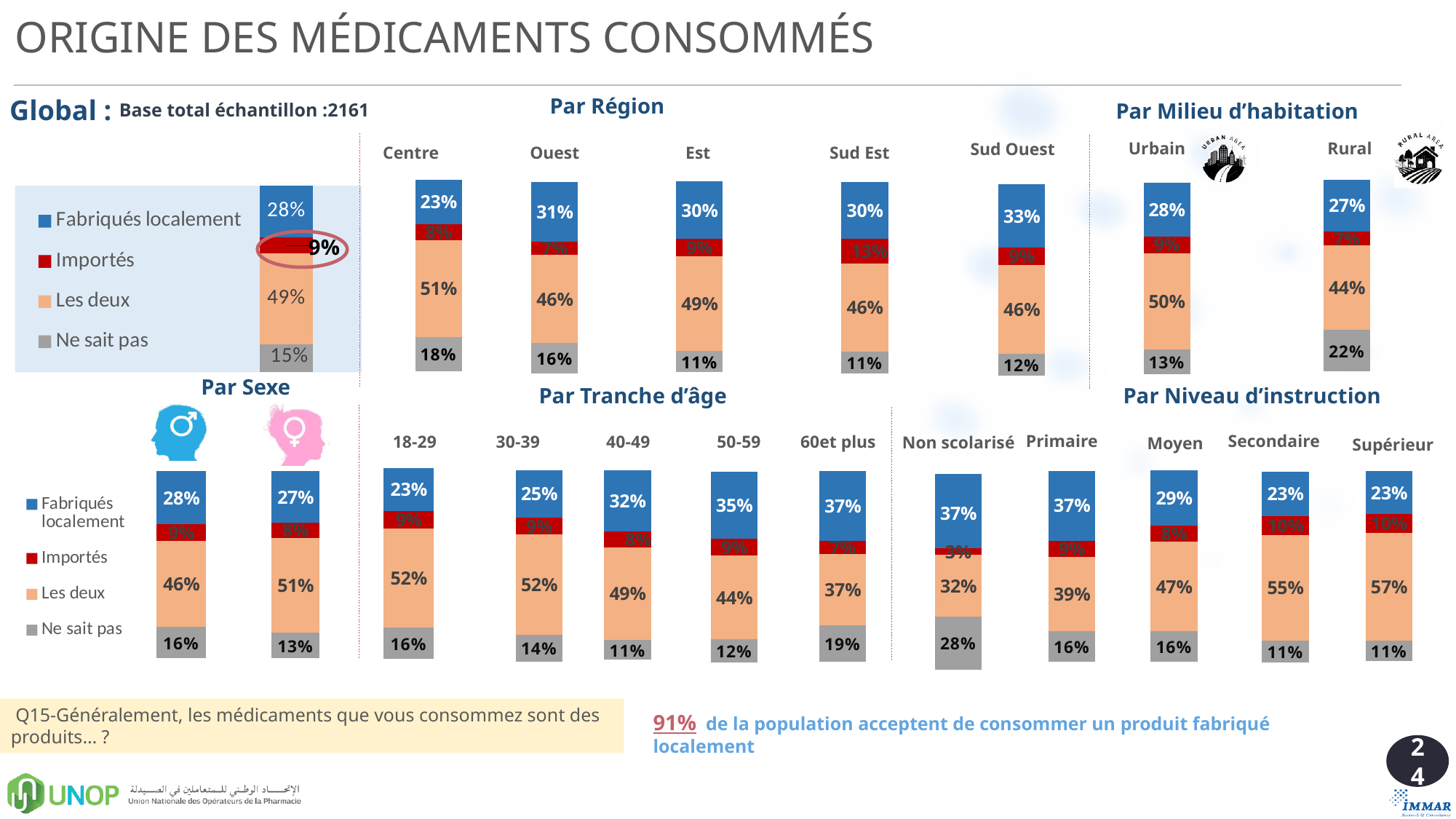
In the Par Niveau d'instruction chart, which education level has the highest "Ne sait pas" value? Non scolarisé In the Par Niveau d'instruction chart, what is the "Les deux" value for Supérieur? 57% In the Global chart, what percentage is shown for "Importés"? 9% In the Par Région chart, which region has the highest "Fabriqués localement" value? Sud Ouest In the Par Tranche d'âge chart, how many age groups are shown? 5 In the Par Sexe chart, which sex has the larger "Les deux" value? Female In the Par Milieu d'habitation chart, what is the difference between the "Les deux" values for Urbain and Rural? 6% In the Global chart, what percentage is shown for "Les deux"? 49% In the Par Région chart, what is the "Ne sait pas" value for Centre? 18% In the Par Tranche d'âge chart, does the "Fabriqués localement" value rise or fall from 18-29 to 60et plus? Rise How many series does the legend of the Global chart list? 4 In the Par Milieu d'habitation chart, what is the "Ne sait pas" value for Rural? 22%